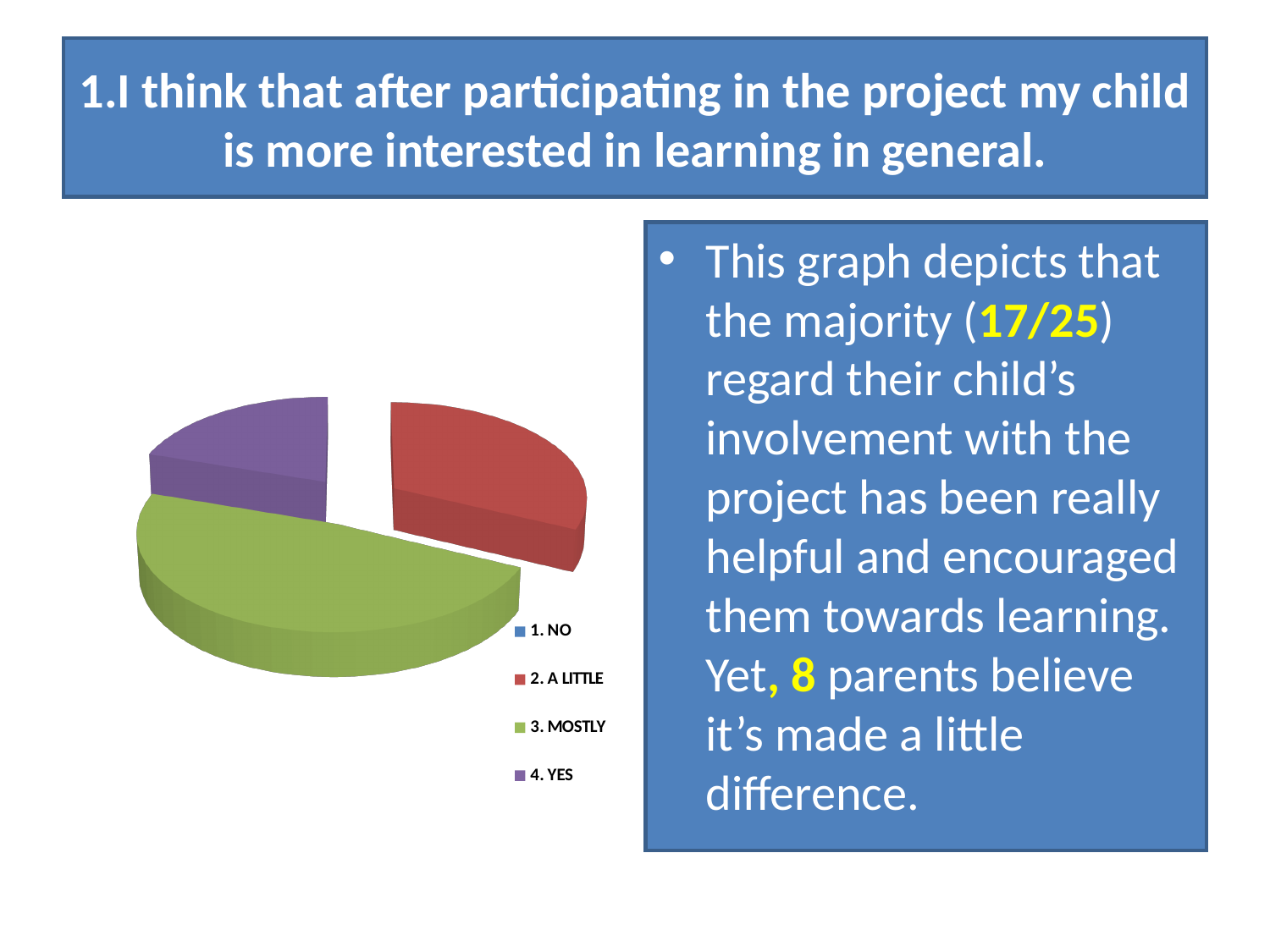
Which slice is larger in the pie chart, 3. MOSTLY or 2. A LITTLE? 3. MOSTLY How many categories does the legend of the pie chart list? 4 What colour is the 3. MOSTLY slice in the pie chart? Green Which category has the largest slice in the pie chart? 3. MOSTLY What kind of chart is shown on the slide? Pie chart Which slice is larger in the pie chart, 3. MOSTLY or 4. YES? 3. MOSTLY Which slice is larger in the pie chart, 2. A LITTLE or 4. YES? 2. A LITTLE Which legend category of the pie chart has no visible slice? 1. NO